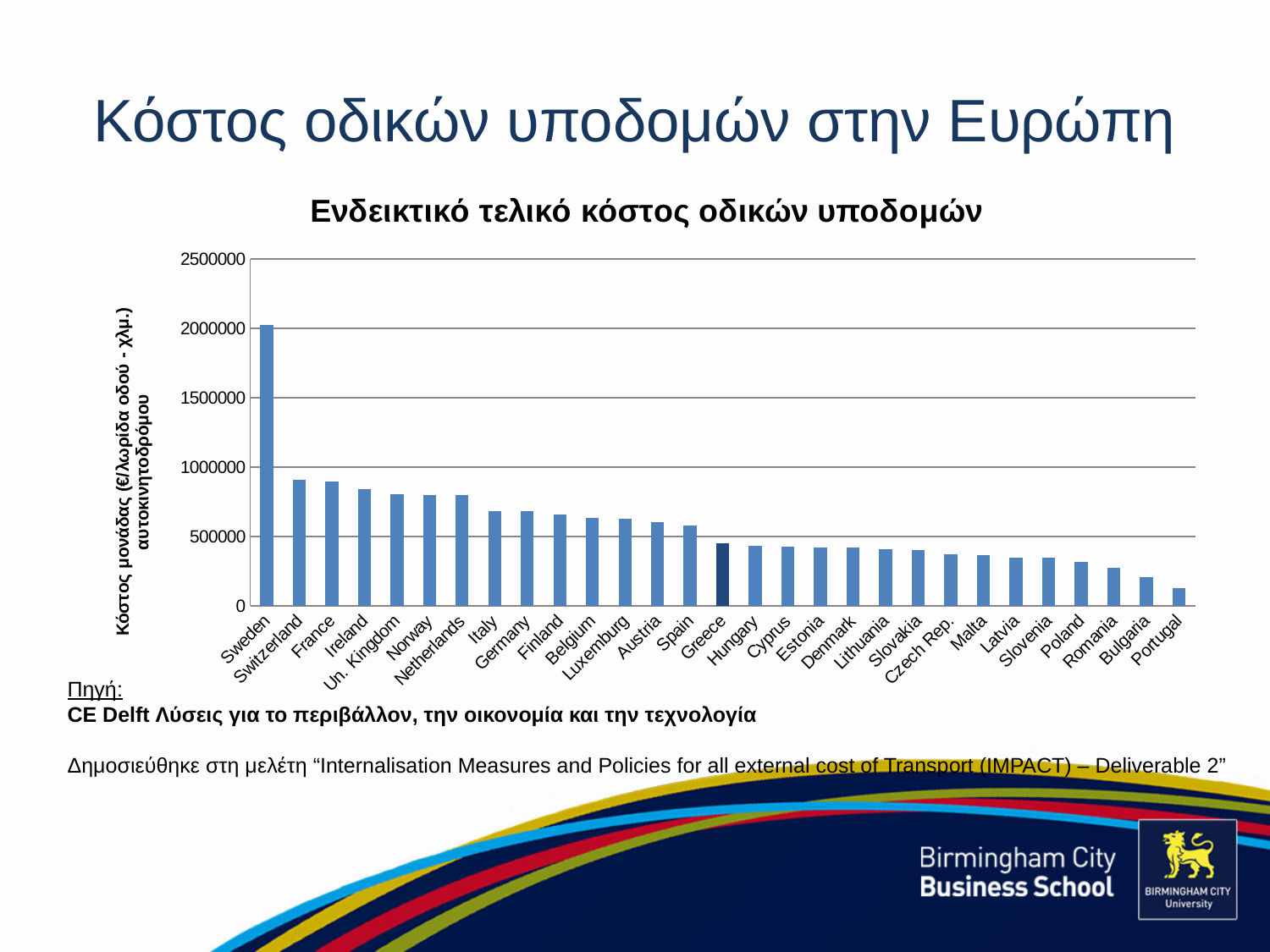
Which country has the highest road infrastructure cost in the chart? Sweden How many countries are shown on the x axis of the chart? 29 Which has a higher value, Greece or Spain? Spain Is the value for Switzerland greater or less than 1000000? less What kind of chart is shown on the slide? bar chart Is the value for Greece greater or less than 500000? less Which has a higher value, Sweden or Switzerland? Sweden Which country has the lowest road infrastructure cost in the chart? Portugal Is the value for Italy greater or less than 500000? greater Which country's bar is shown in a darker colour than the others? Greece Do the values generally rise or fall moving from left to right along the x axis? fall